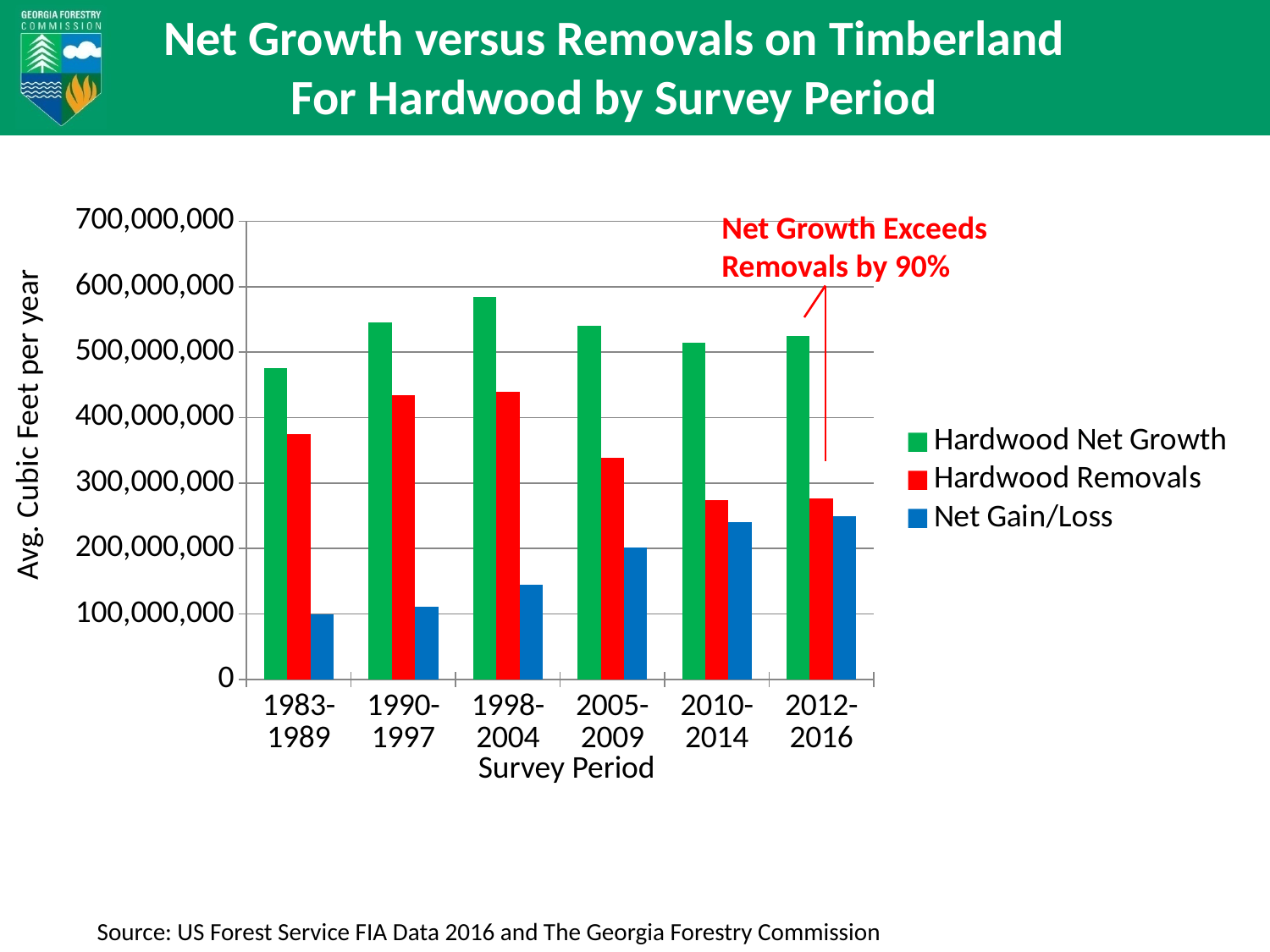
Is the Hardwood Removals value for 2010-2014 greater or less than 300,000,000? less Is the Hardwood Net Growth value for 1983-1989 greater or less than 500,000,000? less Which survey period has the lowest Hardwood Net Growth? 1983-1989 How many survey periods are shown on the x axis? 6 Which is larger for 2005-2009: Hardwood Net Growth or Hardwood Removals? Hardwood Net Growth What does the red annotation on the chart say? Net Growth Exceeds Removals by 90% How many series does the legend list? 3 Which survey period has the highest Hardwood Net Growth? 1998-2004 What kind of chart is shown on the slide? bar chart Does the Net Gain/Loss series generally rise or fall from 1983-1989 to 2012-2016? rise Is the Hardwood Net Growth value for 1998-2004 greater or less than 500,000,000? greater